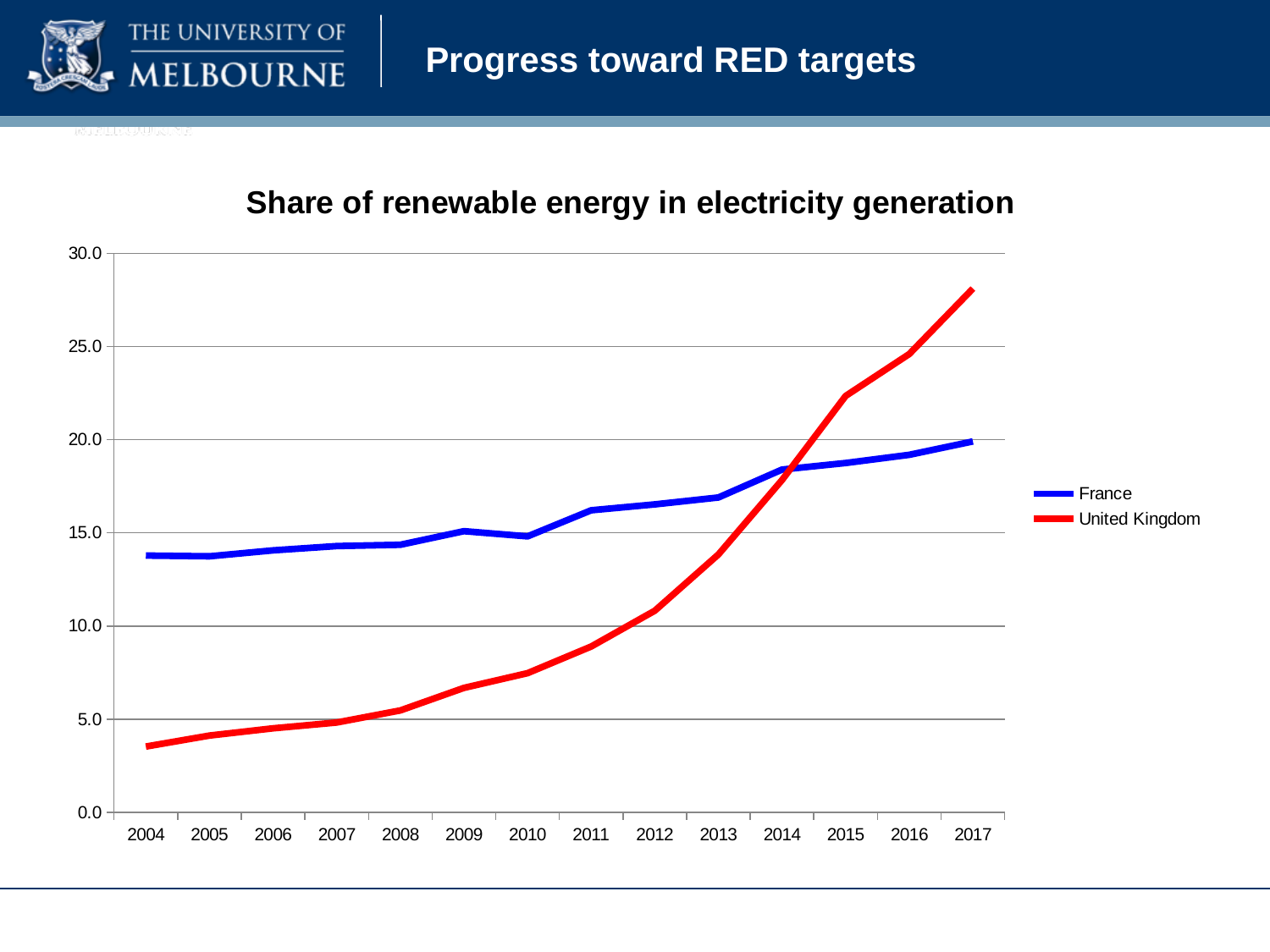
What kind of chart is shown on the slide? line chart Is the value for United Kingdom in 2004 greater or less than 5.0? less How many series does the legend list? 2 Is the value for France in 2004 greater or less than 15.0? less Does the United Kingdom line rise or fall from 2004 to 2017? rise In 2017, which series has the higher value, France or United Kingdom? United Kingdom In 2004, which series has the higher value, France or United Kingdom? France How many years are shown on the x axis? 14 Is the value for United Kingdom in 2010 greater or less than 10.0? less What colour is the line for United Kingdom? red What is the title of the chart? Share of renewable energy in electricity generation